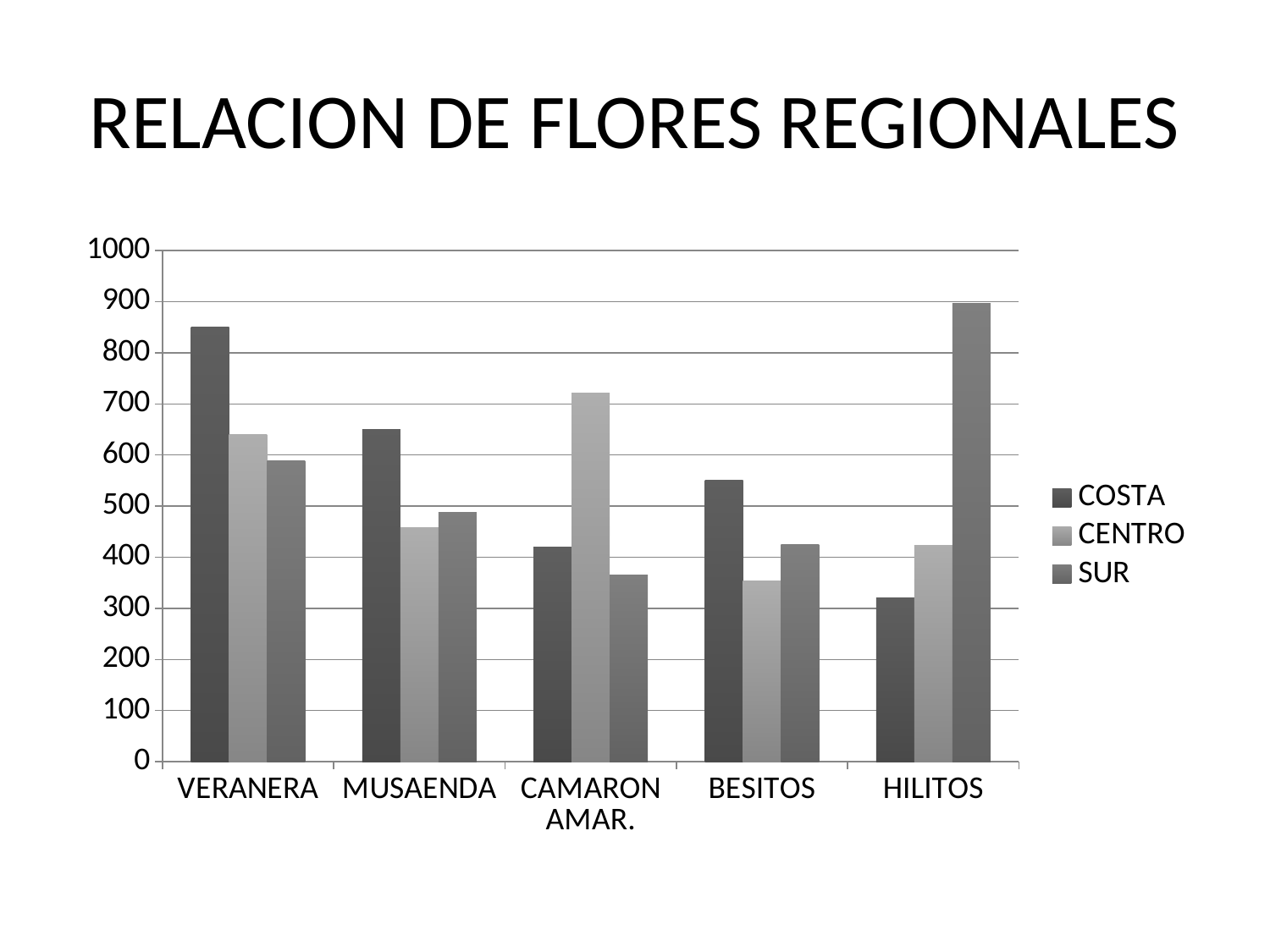
Which category has the highest SUR value? HILITOS Which category has the highest CENTRO value? CAMARON AMAR. Is the COSTA value for VERANERA greater or less than 800? greater What kind of chart is shown on the slide? bar chart Which category has the highest COSTA value? VERANERA How many series does the legend list? 3 How many flower categories are shown on the x axis? 5 Which category has the lowest COSTA value? HILITOS Which category has the lowest SUR value? CAMARON AMAR. What is the title of the chart? RELACION DE FLORES REGIONALES For BESITOS, which is larger, the COSTA value or the SUR value? COSTA